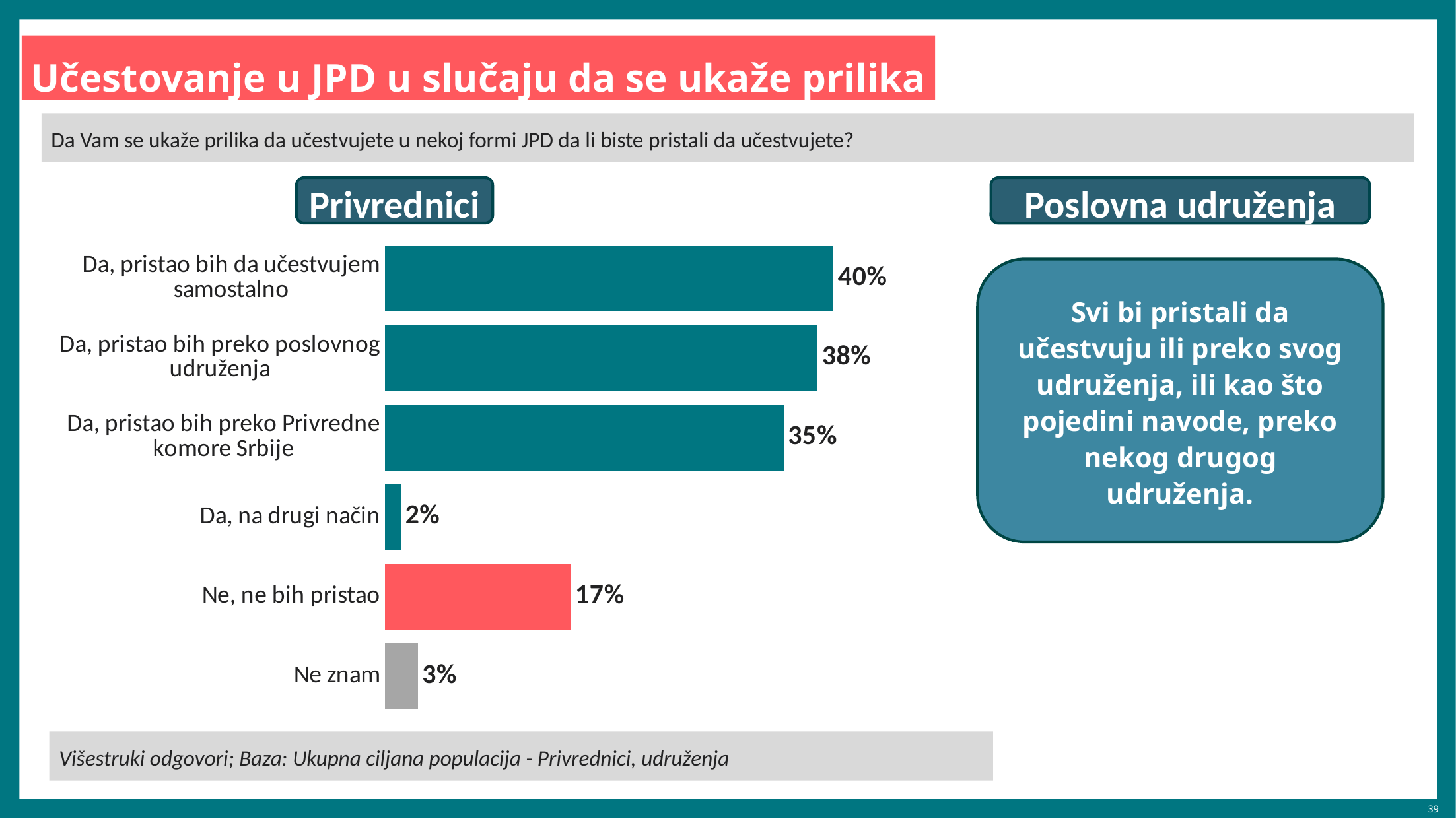
Which category has the lowest value in the Privrednici chart? Da, na drugi način What is the difference between "Da, pristao bih preko poslovnog udruženja" and "Ne, ne bih pristao"? 21% What colour is the bar for "Ne, ne bih pristao"? Red How many categories are shown in the Privrednici chart? 6 Which category has the highest value in the Privrednici chart? Da, pristao bih da učestvujem samostalno What is the value for "Ne znam" in the Privrednici chart? 3% What is the difference between the values for "Ne znam" and "Da, na drugi način"? 1% What percentage of Privrednici answered "Da, pristao bih da učestvujem samostalno"? 40% Which is larger: "Da, pristao bih preko poslovnog udruženja" or "Da, pristao bih preko Privredne komore Srbije"? Da, pristao bih preko poslovnog udruženja What is the value for "Ne, ne bih pristao" in the Privrednici chart? 17% What kind of chart is shown on the slide? Bar chart What is the value for "Da, pristao bih preko Privredne komore Srbije"? 35%